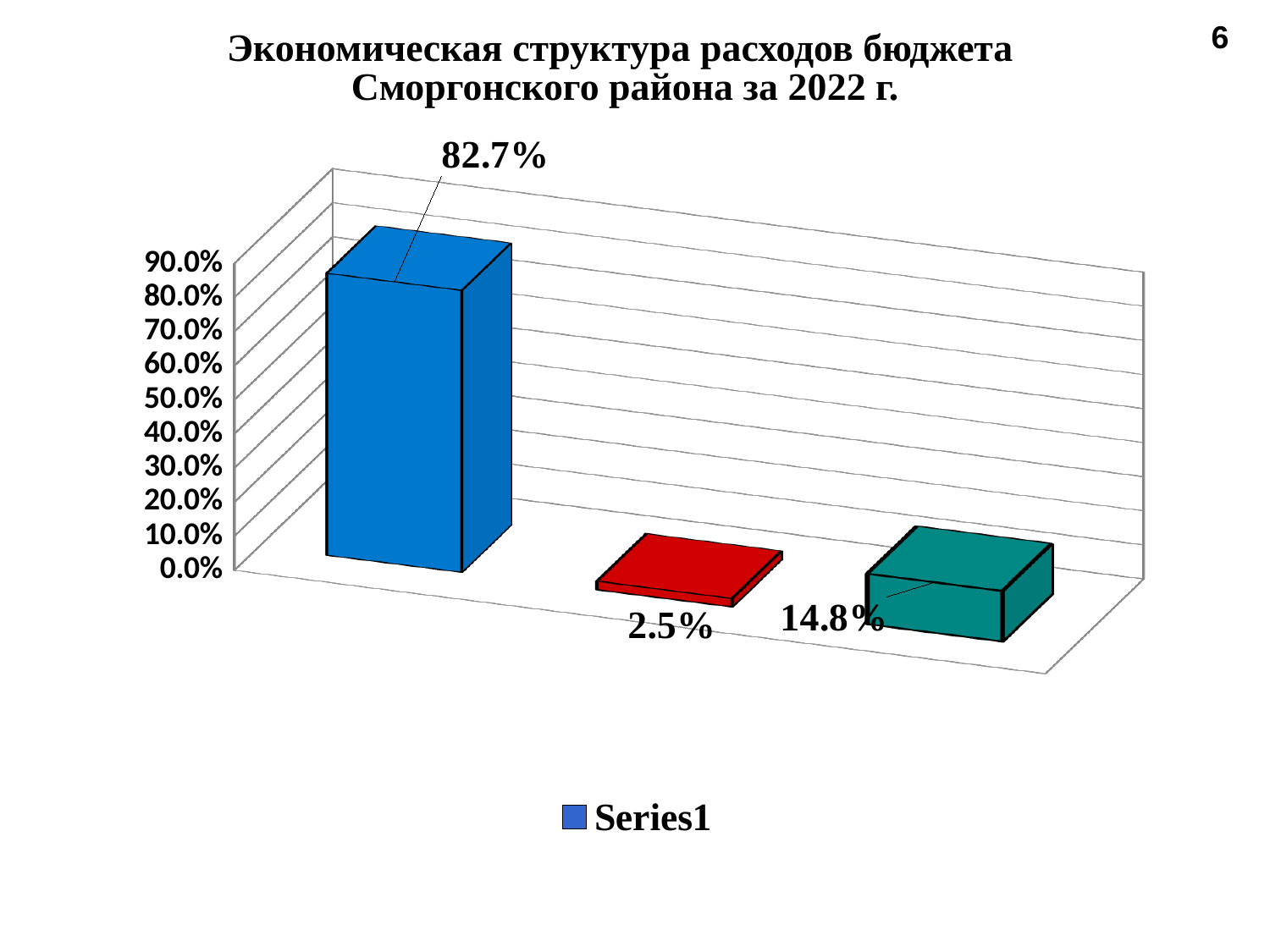
Which is larger, the value of the red bar or the value of the teal bar? The teal bar What value is shown on the red bar (the middle bar)? 2.5% What value is shown on the teal bar (the rightmost bar)? 14.8% What is the title of the chart? Экономическая структура расходов бюджета Сморгонского района за 2022 г. Which bar has the highest value? The blue bar (82.7%) What is the difference between the blue bar's value and the teal bar's value? 67.9% How many series does the legend list? 1 Which bar has the lowest value? The red bar (2.5%) What is the difference between the teal bar's value and the red bar's value? 12.3% What kind of chart is shown on the slide? Bar chart What value is shown on the blue bar (the first bar from the left)? 82.7% How many bars are plotted on the chart? 3